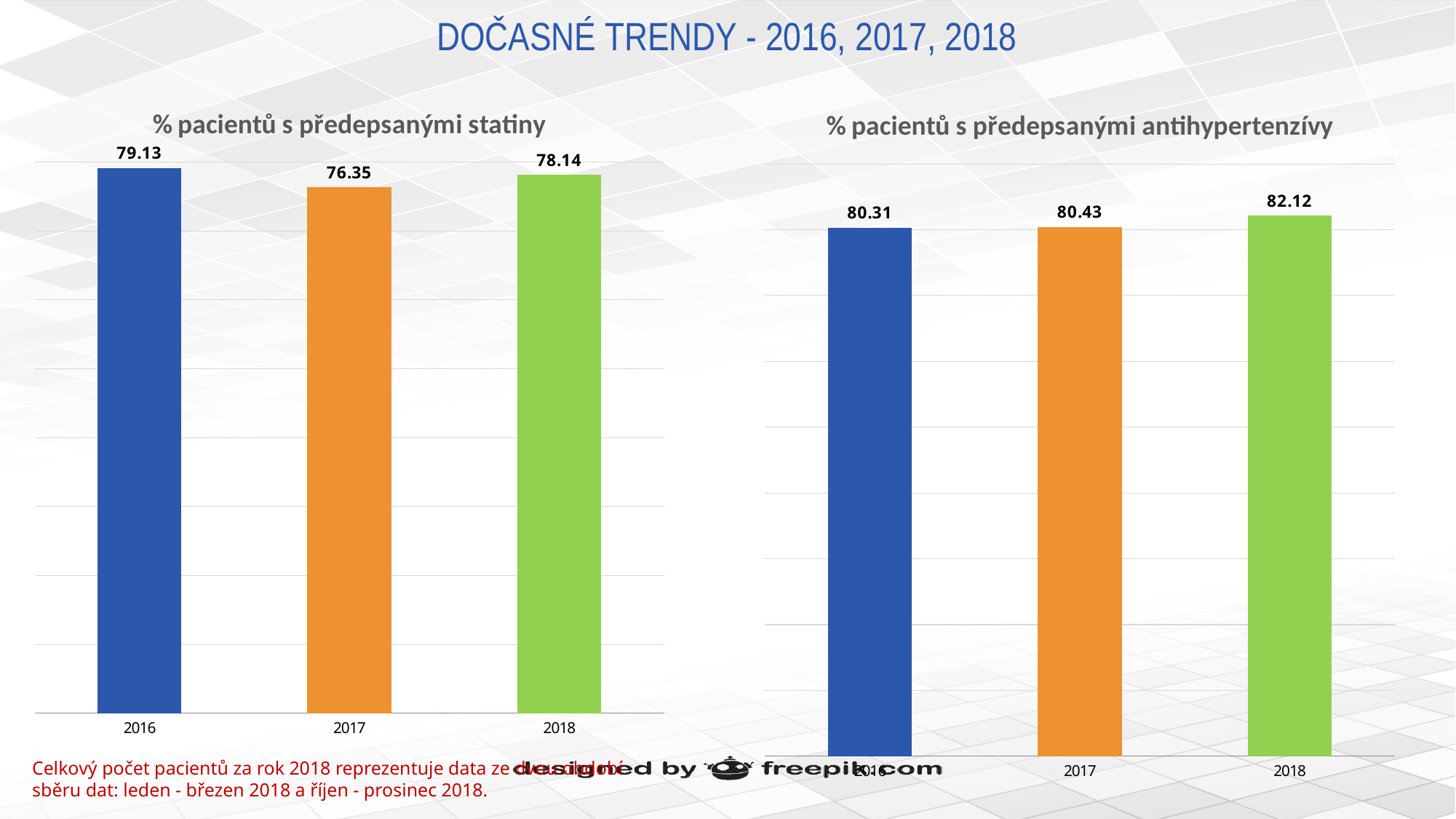
In the chart '% pacientů s předepsanými antihypertenzívy', what is the value for 2018? 82.12 In the chart '% pacientů s předepsanými statiny', what is the value for 2016? 79.13 In the chart '% pacientů s předepsanými antihypertenzívy', what is the difference between the values for 2018 and 2016? 1.81 In the chart '% pacientů s předepsanými statiny', which year has the highest value? 2016 In the chart '% pacientů s předepsanými statiny', which year has the lowest value? 2017 How many bars are shown in the chart '% pacientů s předepsanými antihypertenzívy'? 3 In the chart '% pacientů s předepsanými statiny', which is larger, the value for 2018 or the value for 2017? 2018 In the chart '% pacientů s předepsanými statiny', what is the difference between the values for 2016 and 2017? 2.78 In the chart '% pacientů s předepsanými antihypertenzívy', which year has the highest value? 2018 What type of chart is the chart on the left of the slide? Bar chart In the chart '% pacientů s předepsanými antihypertenzívy', what is the value for 2016? 80.31 In the chart '% pacientů s předepsanými statiny', what is the value for 2017? 76.35